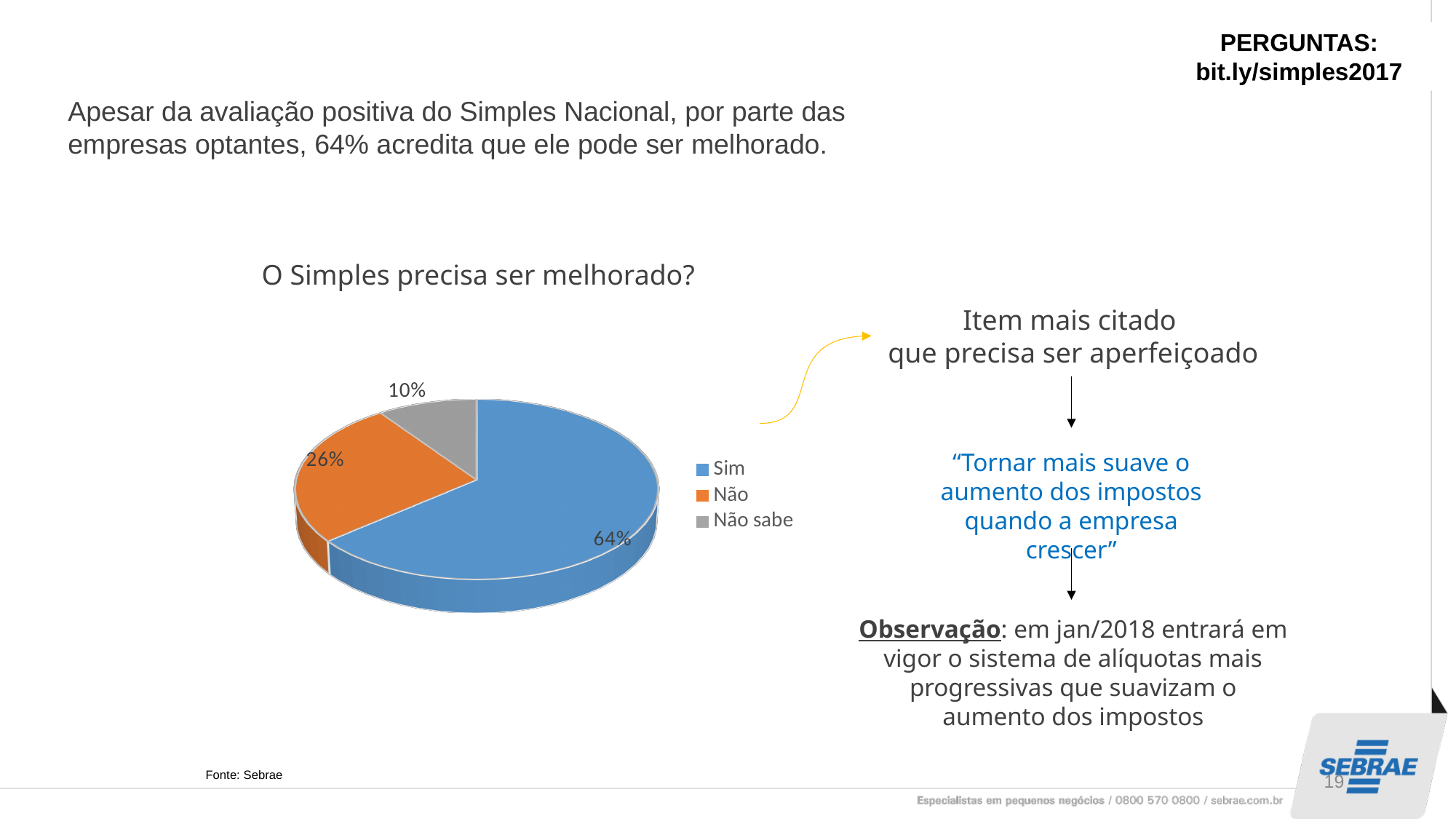
Which category has the largest slice of the pie? Sim What colour is the "Não" slice in the pie chart? orange What kind of chart is shown on the slide? pie chart Which is larger, the slice for "Não" or the slice for "Não sabe"? Não What is the title of the pie chart? O Simples precisa ser melhorado? What share of the pie does "Não" represent? 26% What share of the pie does "Sim" represent? 64% What share of the pie does "Não sabe" represent? 10% How many categories does the pie chart have? 3 How many entries does the legend list? 3 Which category has the smallest slice of the pie? Não sabe What is the difference in percentage points between "Sim" and "Não"? 38